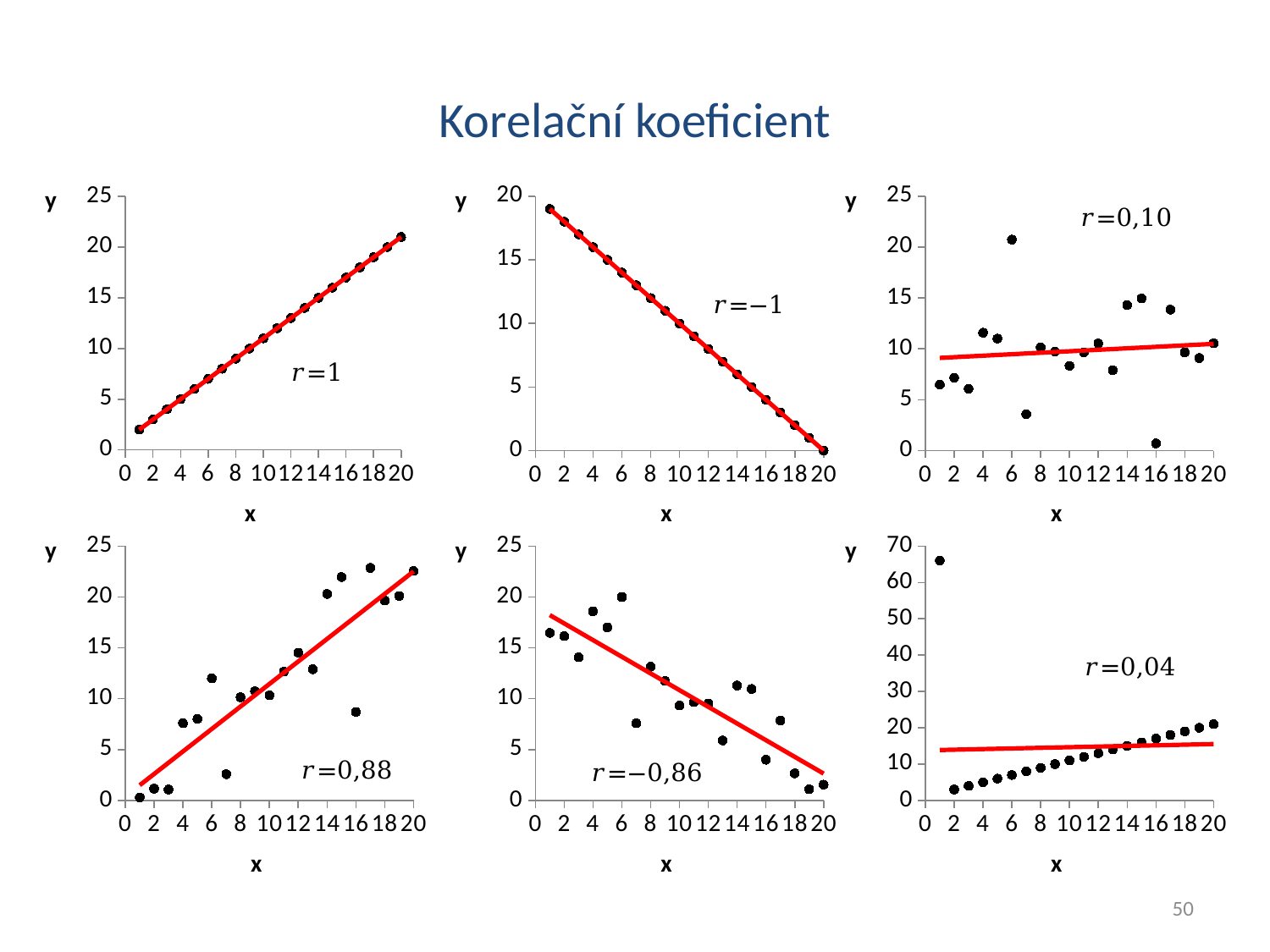
What correlation coefficient r is printed on the bottom-left chart? r=0,88 In the top-middle chart, do the y values rise or fall as x increases? fall How many charts are shown on the slide? 6 In the bottom-left chart, is the y value at x = 16 greater or less than 10? less In the top-left chart, do the y values rise or fall as x increases? rise How many data points are plotted in the top-left chart? 20 In the top-right chart, at which x value is y lowest? 16 What kind of chart is the top-left chart? scatter chart In the bottom-right chart, at which x value is y highest? 1 In the bottom-middle chart, do the y values rise or fall as x increases? fall In the top-middle chart, at which x value is y highest? 1 In the bottom-right chart, is the y value at x = 1 greater or less than 60? greater